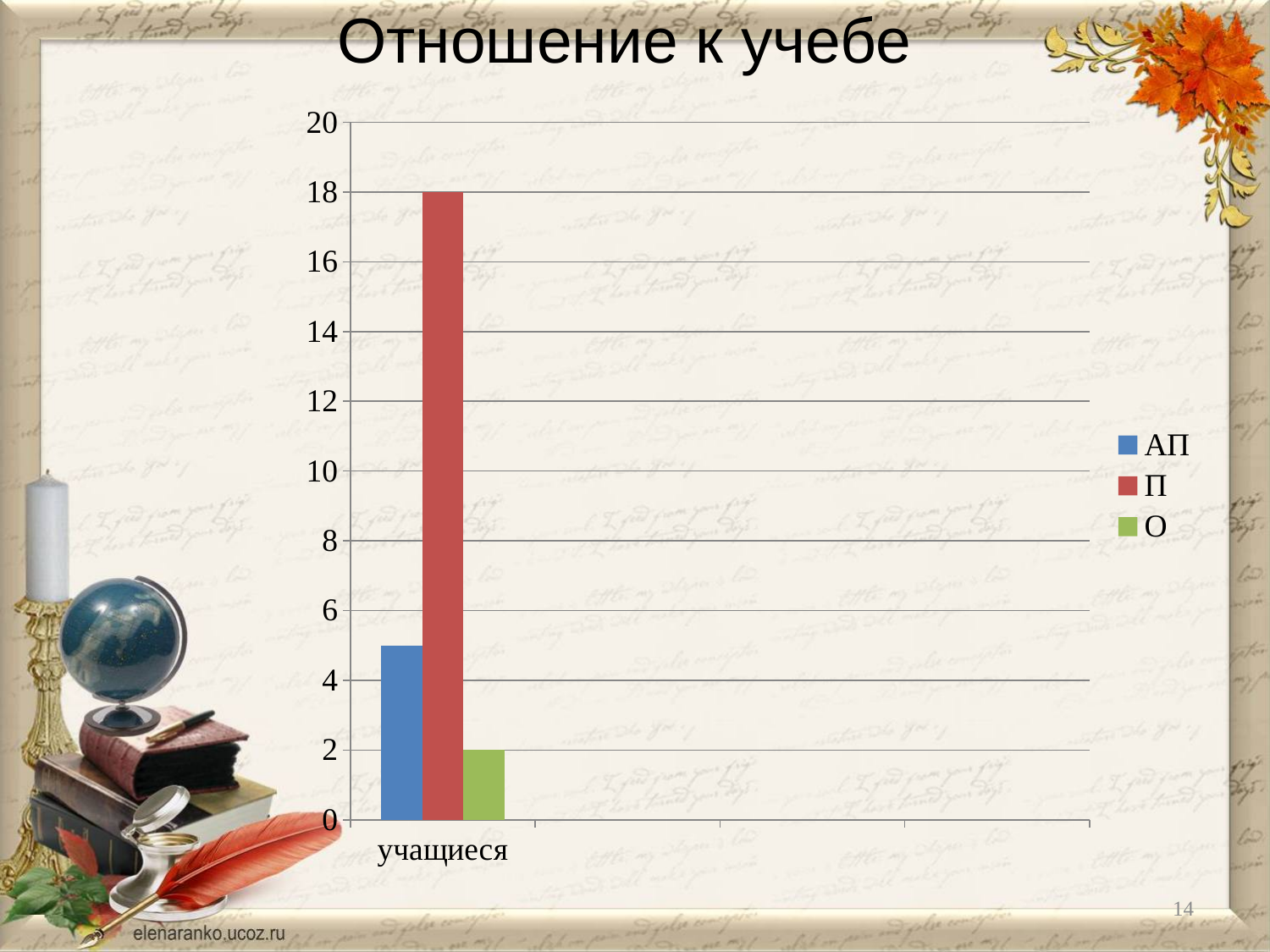
Is the value of the АП series for учащиеся greater or less than 4? greater How many series does the legend list? 3 Is the value of the АП series for учащиеся greater or less than 6? less Which is larger for учащиеся, the АП series or the О series? АП What is the title of the chart? Отношение к учебе What is the value of the О series for учащиеся? 2 What is the value of the П series for учащиеся? 18 Which series has the highest value for учащиеся? П What kind of chart is shown on the slide? bar chart What colour represents the П series in the legend? red Which series has the lowest value for учащиеся? О What is the difference between the П value and the О value for учащиеся? 16